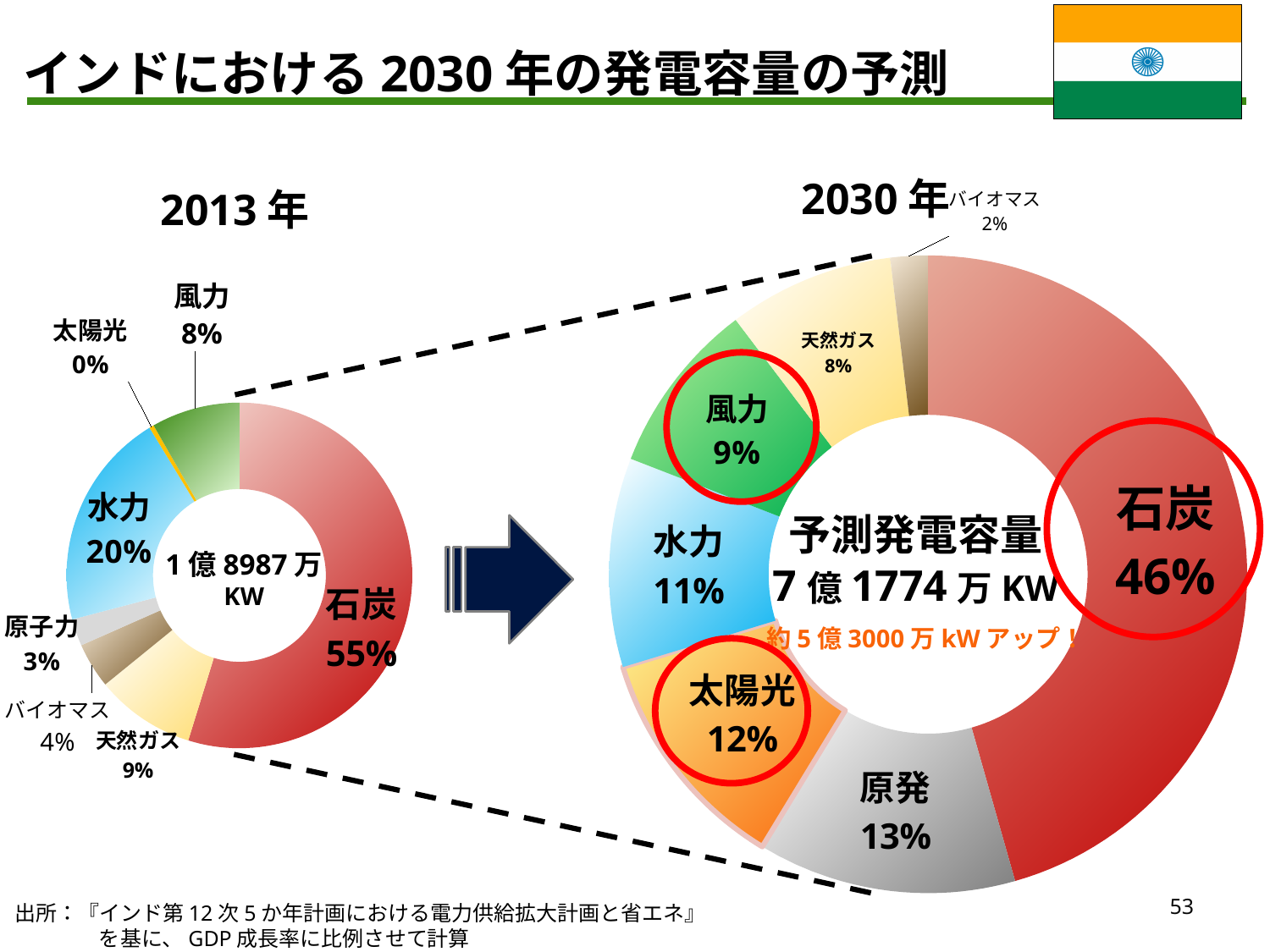
In the 2030年 chart, which is larger, the share for 原発 or the share for 水力? 原発 In the 2013年 chart, what is the share for 水力? 20% How many categories are shown in the 2030年 chart? 7 What is the difference between the 石炭 share in the 2013年 chart and the 石炭 share in the 2030年 chart? 9% In the 2030年 chart, which category has the largest share? 石炭 In the 2030年 chart, which category has the smallest share? バイオマス In the 2030年 chart, what is the share for 石炭? 46% In the 2030年 chart, what is the share for 太陽光? 12% What total capacity is printed in the center of the 2030年 chart? 7億1774万KW What kind of chart is used for the 2013年 data? Donut (pie) chart In the 2013年 chart, which category has the smallest share? 太陽光 In the 2013年 chart, what is the share for 石炭? 55%